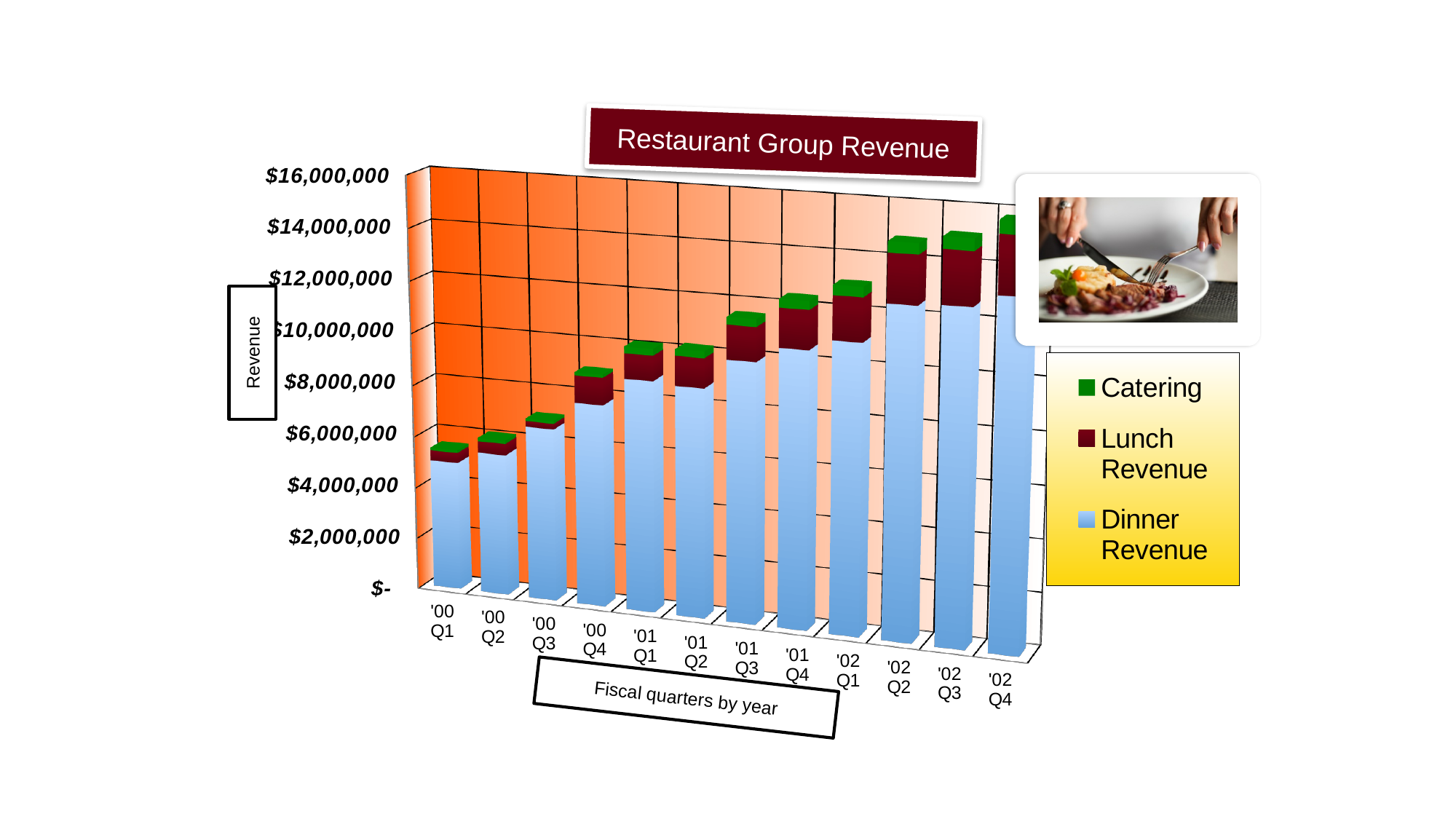
Is the total revenue for '02 Q4 greater or less than $12,000,000? greater Do total revenues generally rise or fall from '00 Q1 to '02 Q4? rise Which has the larger total revenue, '02 Q2 or '00 Q3? '02 Q2 Is the total revenue for '01 Q1 greater or less than $8,000,000? greater How many fiscal quarters are plotted along the x axis? 12 What kind of chart is shown on the slide? bar chart How many series does the legend list? 3 What is the title of the chart? Restaurant Group Revenue Is the total revenue for '00 Q1 greater or less than $6,000,000? less Which series is shown in green in the legend? Catering Which fiscal quarter has the highest total revenue? '02 Q4 Which fiscal quarter has the lowest total revenue? '00 Q1